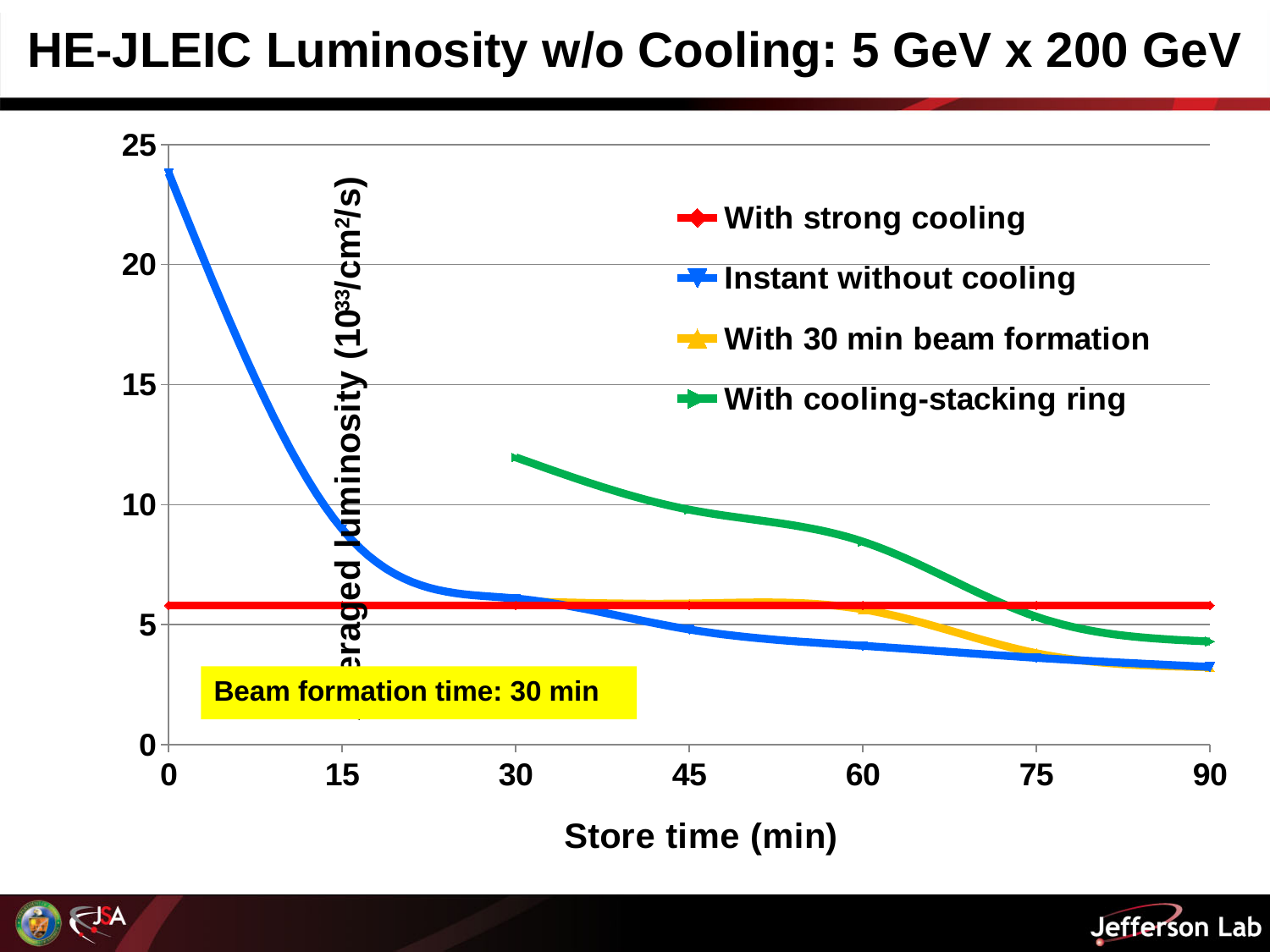
How many series does the legend list? 4 Is the value of 'With 30 min beam formation' at store time 90 greater or less than 5? less Does the 'Instant without cooling' series rise or fall as store time increases? fall Which series has the highest value at store time 30? With cooling-stacking ring Is the value of 'Instant without cooling' at store time 0 greater or less than 20? greater At store time 45, which is larger: 'With cooling-stacking ring' or 'Instant without cooling'? With cooling-stacking ring What kind of chart is shown on the slide? line chart What is the label of the x axis? Store time (min) Is the value of 'With strong cooling' greater or less than 10? less Which series is drawn in green? With cooling-stacking ring At store time 60, which is larger: 'With cooling-stacking ring' or 'With strong cooling'? With cooling-stacking ring